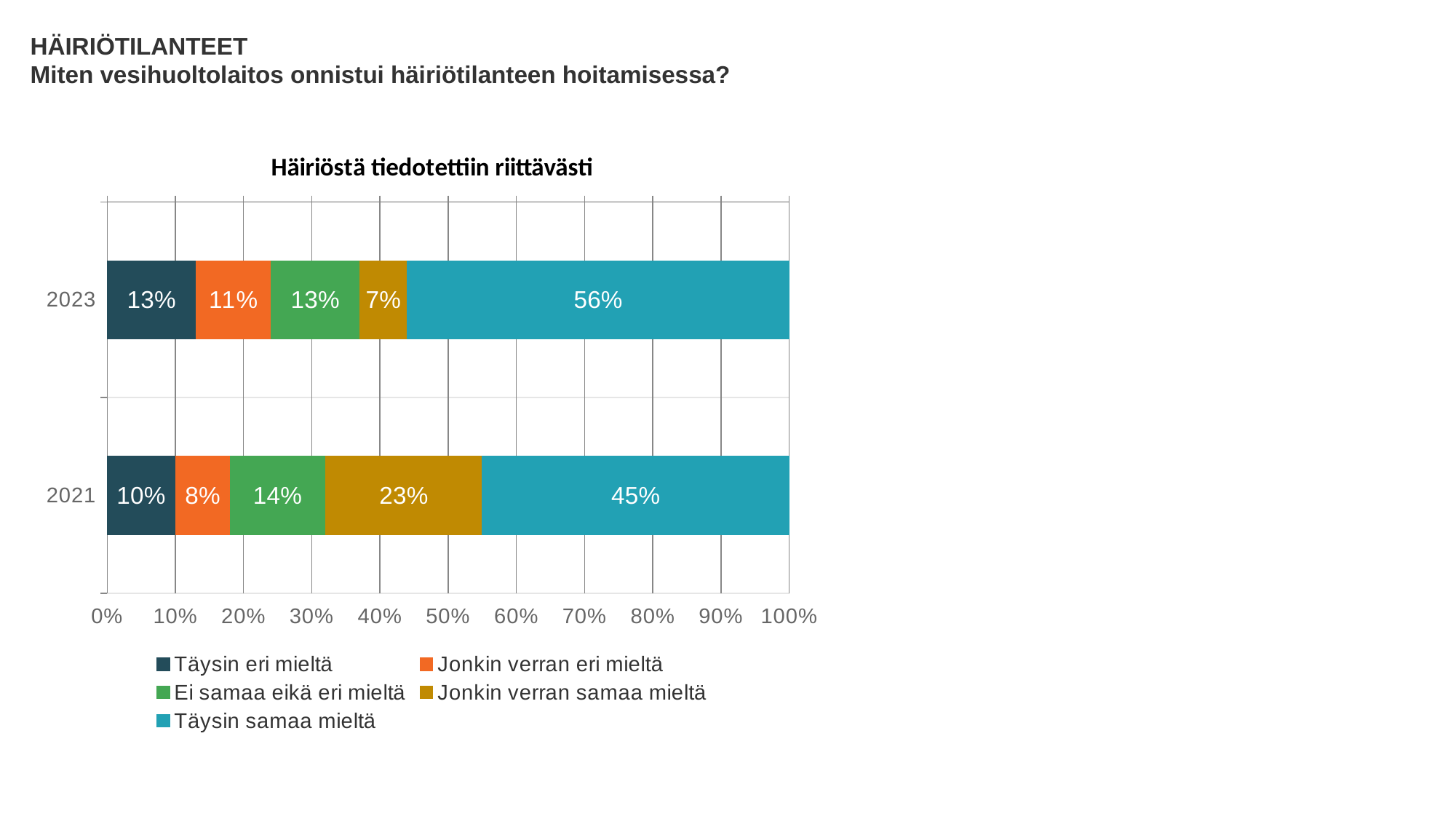
Which response category has the largest share in the 2021 bar? Täysin samaa mieltä What is the value for "Jonkin verran eri mieltä" in 2023? 11% What is the value for "Jonkin verran samaa mieltä" in 2021? 23% How many series does the legend list? 5 Which year has the higher value for "Täysin samaa mieltä", 2021 or 2023? 2023 What is the value for "Täysin eri mieltä" in 2021? 10% What is the title of the chart? Häiriöstä tiedotettiin riittävästi How many years (categories) are shown on the chart? 2 What is the value for "Täysin samaa mieltä" in 2023? 56% What is the difference between the "Jonkin verran samaa mieltä" values for 2021 and 2023? 16% What kind of chart is shown? Stacked bar chart Which response category has the smallest share in the 2023 bar? Jonkin verran samaa mieltä